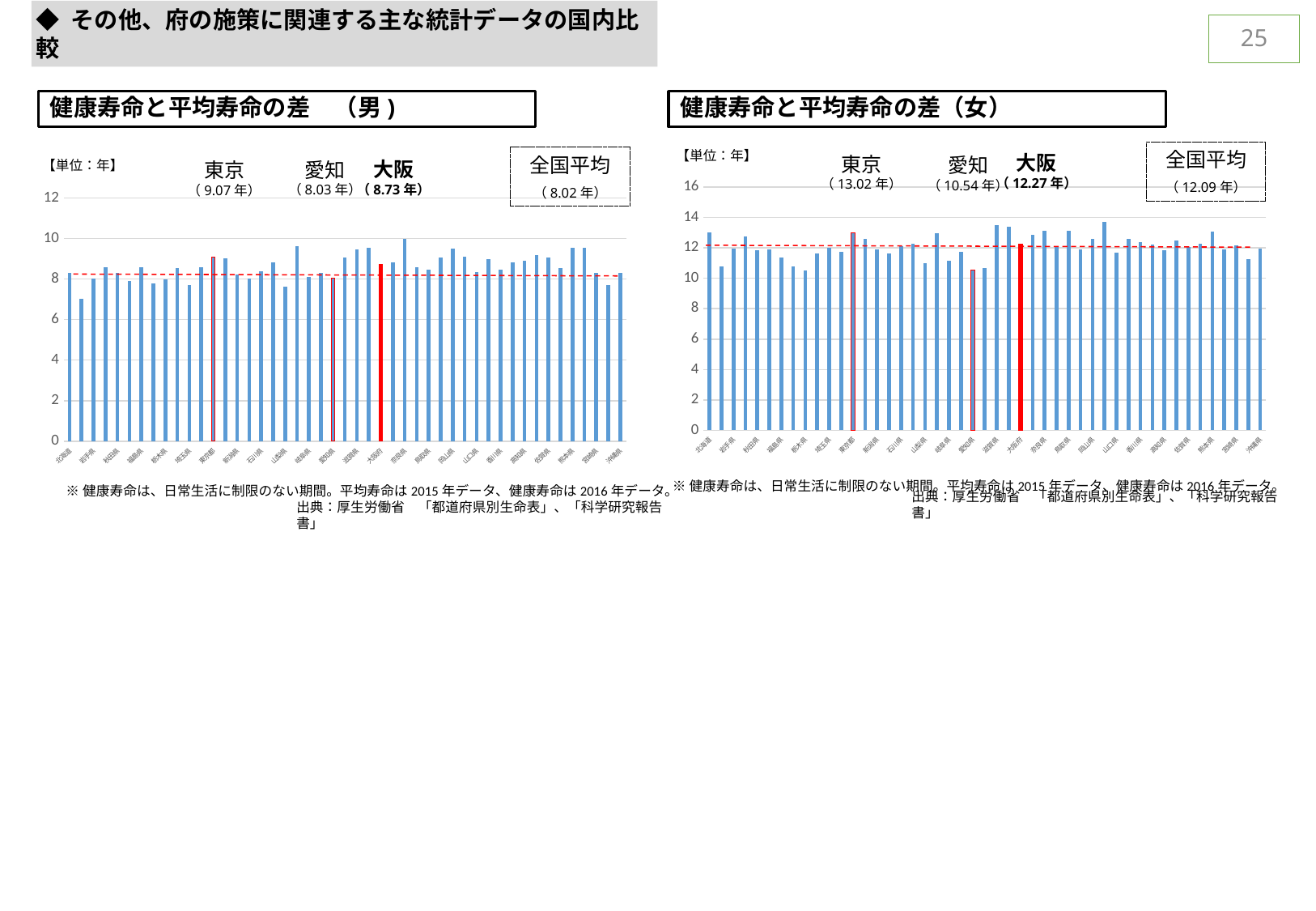
In the left chart (健康寿命と平均寿命の差（男）), what is the value shown for 大阪? 8.73年 In the right chart (健康寿命と平均寿命の差（女）), what is the difference between the value for 大阪 and the 全国平均? 0.18年 In the left chart (健康寿命と平均寿命の差（男）), which is larger, the value for 大阪 or the value for 愛知? 大阪 In the right chart (健康寿命と平均寿命の差（女）), what unit are the values expressed in? 年 In the left chart (健康寿命と平均寿命の差（男）), what is the difference between the value for 東京 and the value for 大阪? 0.34年 In the right chart (健康寿命と平均寿命の差（女）), which of the three labelled prefectures (東京, 愛知, 大阪) has the highest value? 東京 What kind of chart is used in the left chart (健康寿命と平均寿命の差（男）)? bar chart In the left chart (健康寿命と平均寿命の差（男）), what is the 全国平均 value? 8.02年 In the right chart (健康寿命と平均寿命の差（女）), what is the value shown for 大阪? 12.27年 In the left chart (健康寿命と平均寿命の差（男）), what is the value shown for 東京? 9.07年 In the right chart (健康寿命と平均寿命の差（女）), what is the value shown for 愛知? 10.54年 In the right chart (健康寿命と平均寿命の差（女）), what is the 全国平均 value? 12.09年